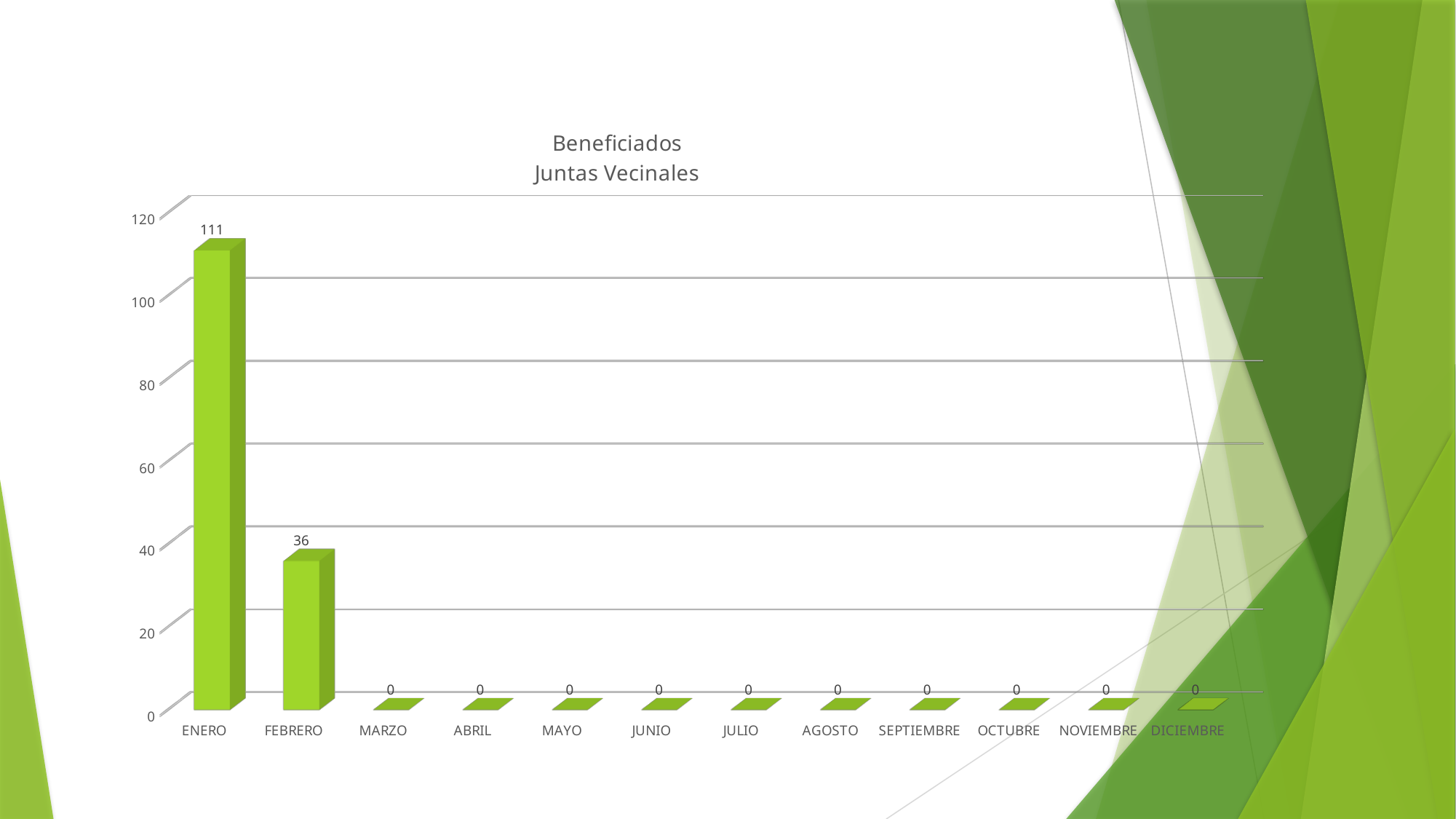
What is the value for MARZO? 0 How many months are shown on the x axis? 12 What is the value for ENERO? 111 What is the value for FEBRERO? 36 Which is larger, the value for ENERO or the value for FEBRERO? ENERO Which month has the highest value? ENERO What is the difference between the values for ENERO and FEBRERO? 75 Is the value for ENERO greater or less than 100? greater What is the title of the chart? Beneficiados Juntas Vecinales Is the value for FEBRERO greater or less than 40? less What kind of chart is shown? bar chart Do the values rise or fall from ENERO to MARZO? fall